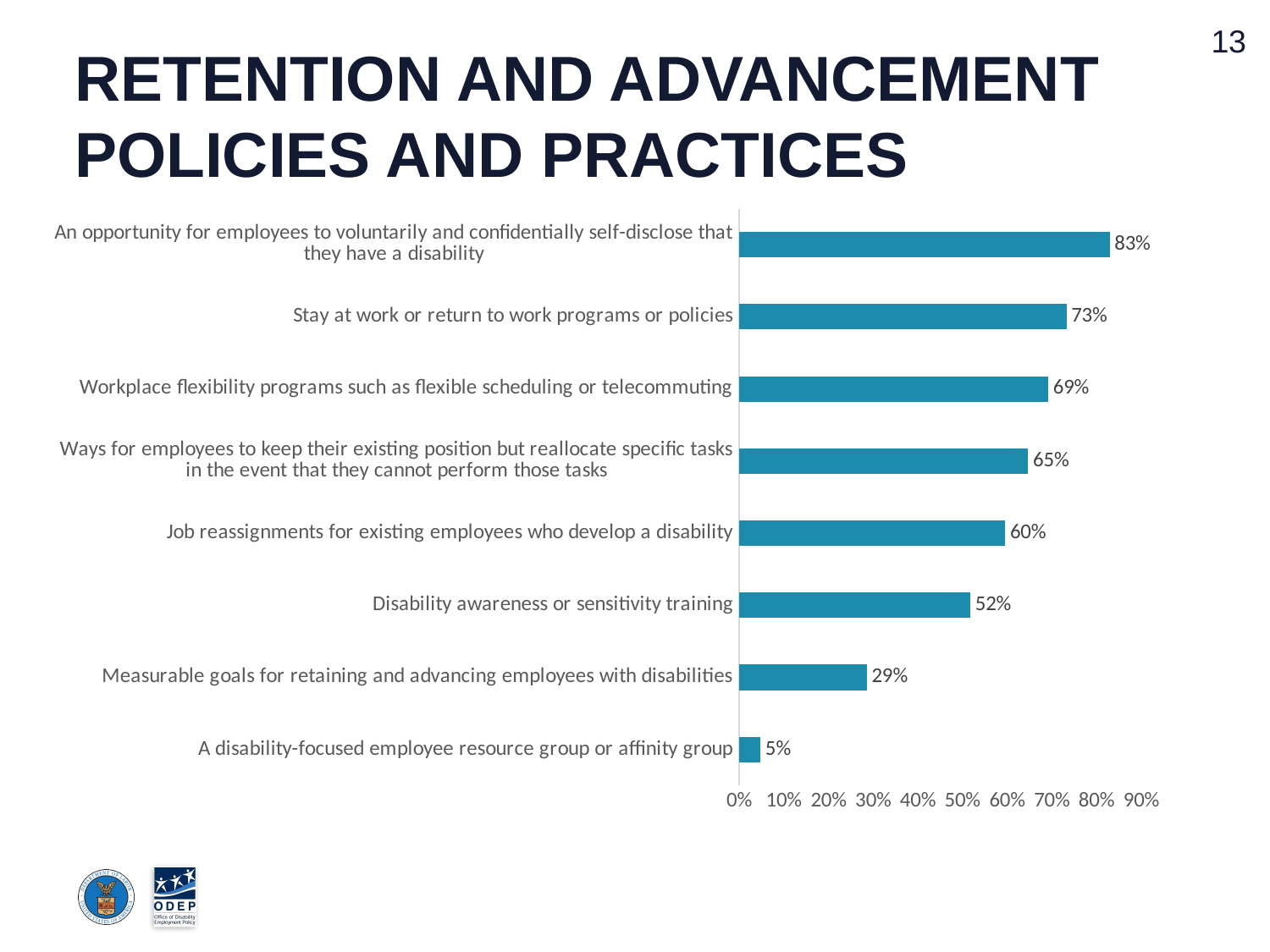
How many categories are shown in the chart? 8 Which is larger: the value for "Stay at work or return to work programs or policies" or the value for "Disability awareness or sensitivity training"? Stay at work or return to work programs or policies What is the maximum value shown on the x axis? 90% Is the value for "Ways for employees to keep their existing position but reallocate specific tasks in the event that they cannot perform those tasks" greater or less than 50%? greater What percentage is shown for "Measurable goals for retaining and advancing employees with disabilities"? 29% What is the difference between the values for "Workplace flexibility programs such as flexible scheduling or telecommuting" and "Job reassignments for existing employees who develop a disability"? 9% What kind of chart is shown on the slide? Bar chart What is the difference between the highest and lowest values in the chart? 78% What is the value for "Disability awareness or sensitivity training"? 52% What percentage is shown for "Stay at work or return to work programs or policies"? 73% Which category has the highest value? An opportunity for employees to voluntarily and confidentially self-disclose that they have a disability Which category has the lowest value? A disability-focused employee resource group or affinity group